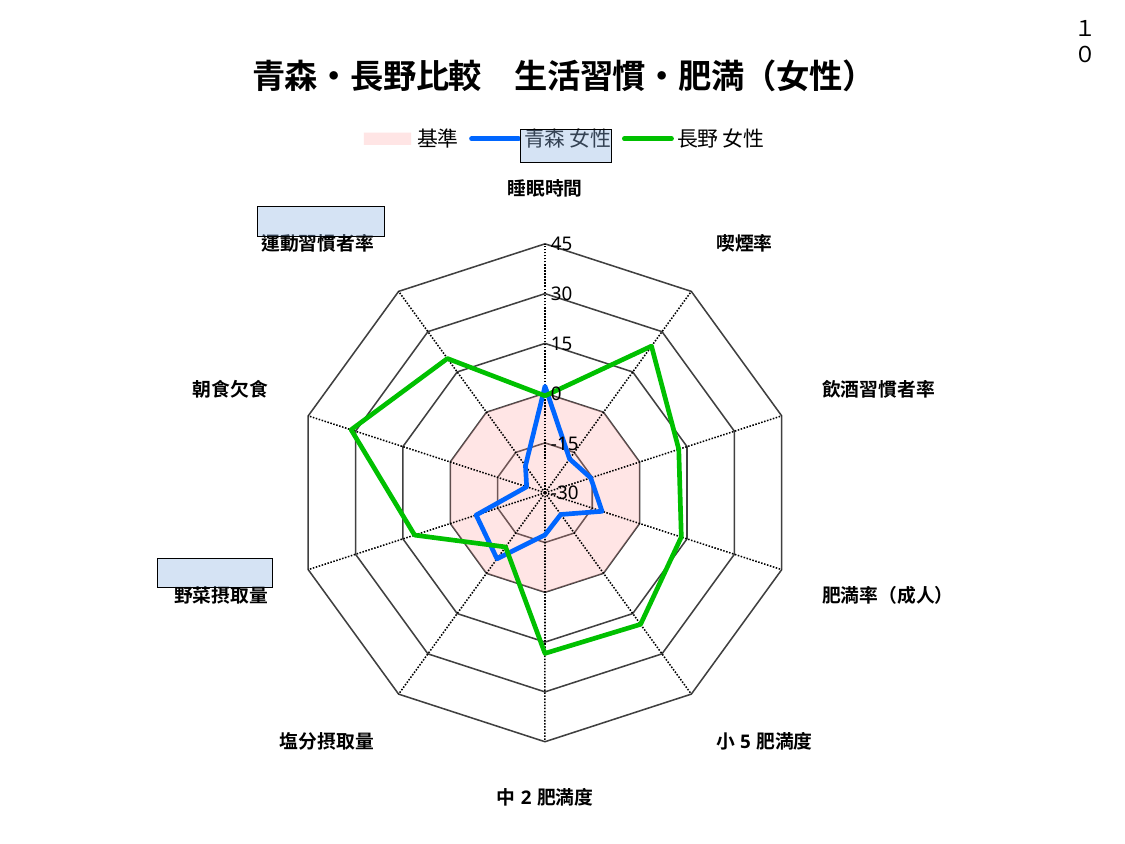
Is the value of 青森 女性 for 飲酒習慣者率 greater or less than 0? less Which series is drawn with the green line? 長野 女性 Is the value of 長野 女性 for 喫煙率 greater or less than 15? greater How many series does the legend list? 3 How many categories (axes) does the radar chart have? 10 Is the value of 長野 女性 for 朝食欠食 greater or less than 15? greater What is the title of the chart? 青森・長野比較 生活習慣・肥満（女性） For 小５肥満度, which series has the larger value, 青森 女性 or 長野 女性? 長野 女性 For 朝食欠食, which series has the larger value, 青森 女性 or 長野 女性? 長野 女性 For 喫煙率, which series has the larger value, 青森 女性 or 長野 女性? 長野 女性 What kind of chart is shown on the slide? radar chart